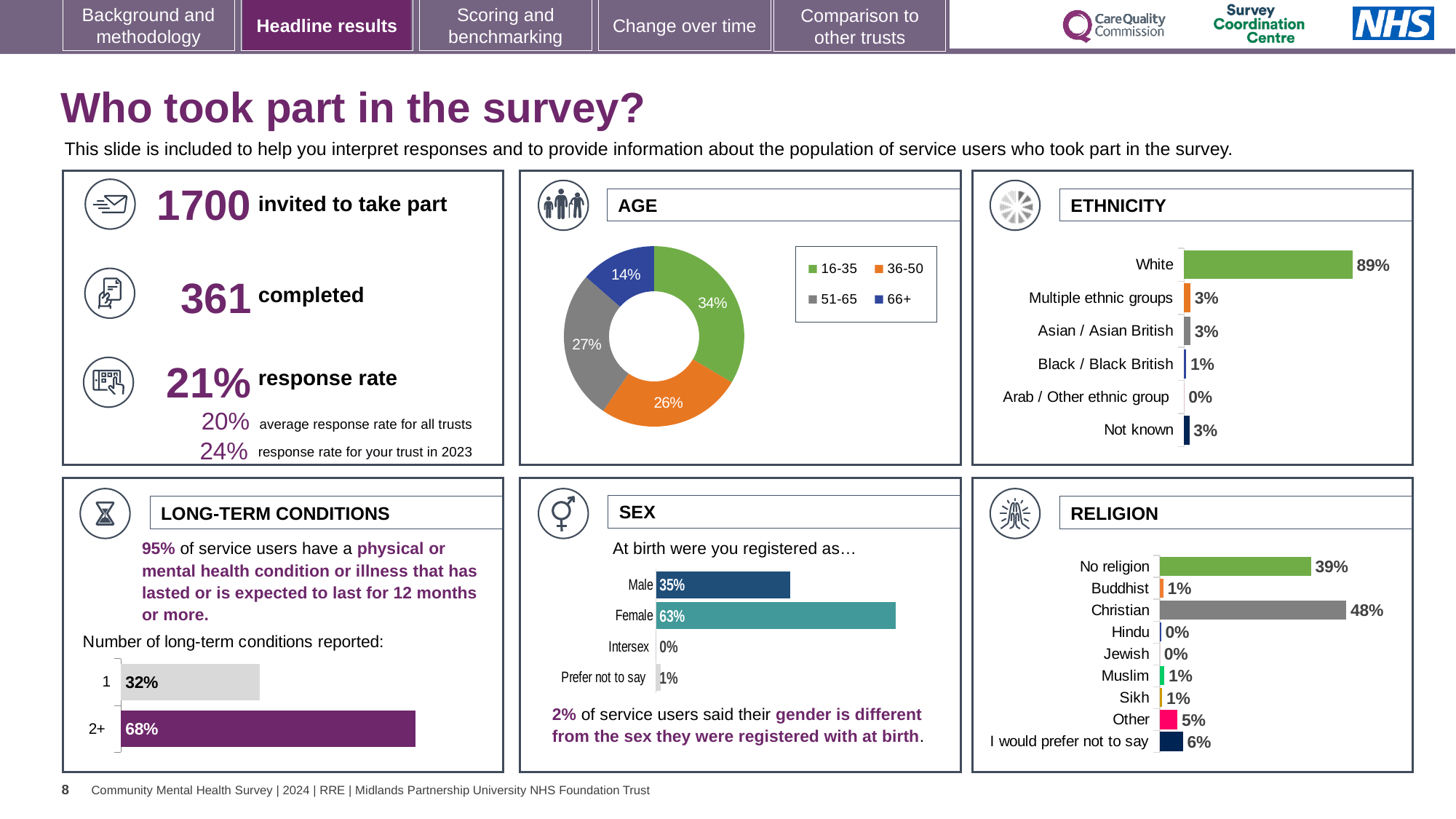
In the ETHNICITY chart, which category has the lowest value? Arab / Other ethnic group In the LONG-TERM CONDITIONS chart, what percentage reported 2+ long-term conditions? 68% In the SEX chart, what is the difference between the Female and Male values? 28% In the ETHNICITY chart, what is the value for White? 89% In the RELIGION chart, what is the value for I would prefer not to say? 6% In the RELIGION chart, which category has the highest value? Christian How many age groups does the legend of the AGE chart list? 4 In the AGE chart, which age group has the smallest share? 66+ What kind of chart is the AGE chart? Doughnut chart How many categories are shown in the ETHNICITY chart? 6 In the AGE chart, what percentage of respondents were aged 16-35? 34% In the SEX chart, which is larger, Male or Female? Female